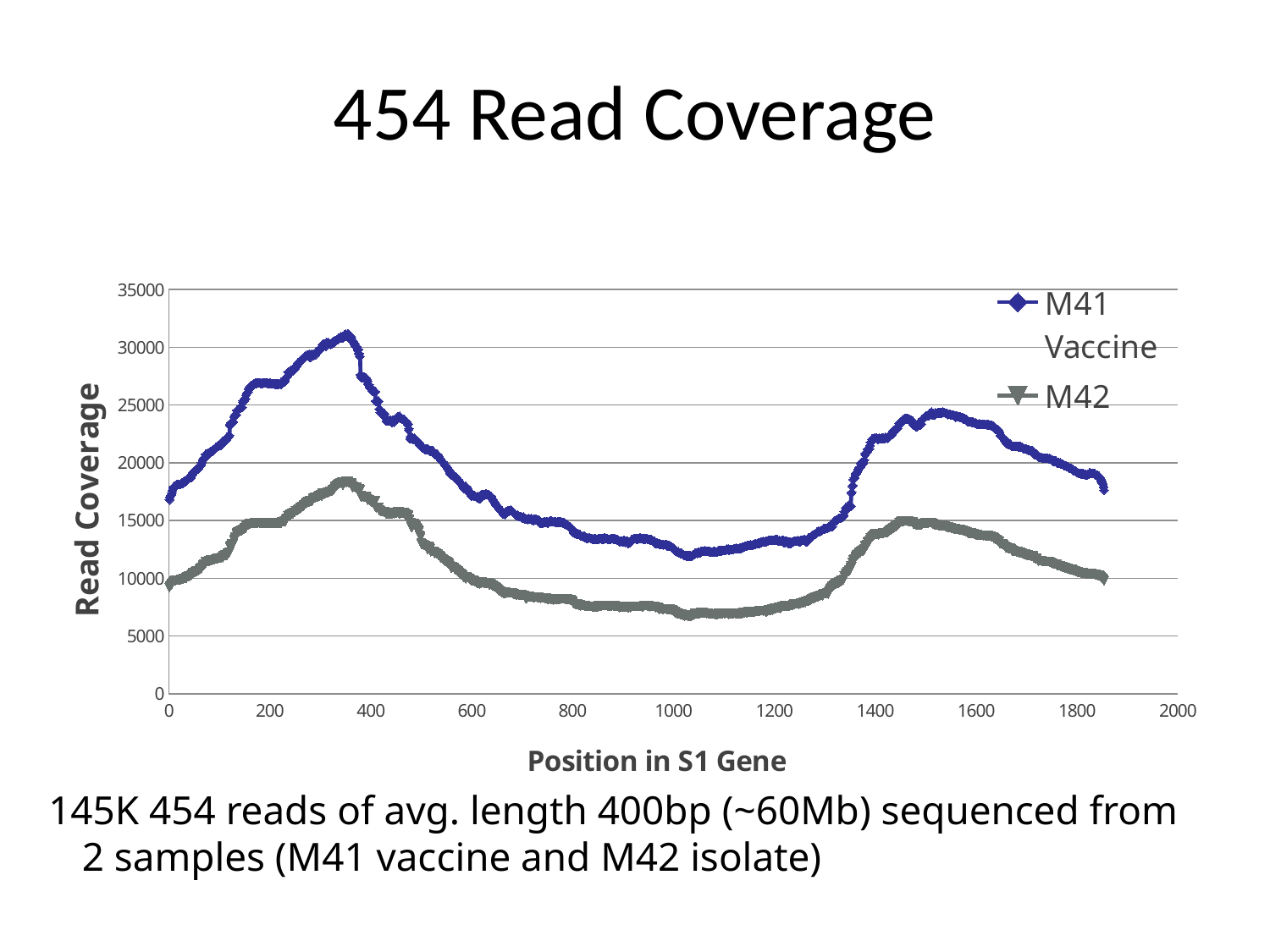
At position 1000, is the read coverage for M41 Vaccine greater or less than 15000? less At position 1600, is the read coverage for M41 Vaccine greater or less than 20000? greater What kind of chart is shown on the slide? line chart Does the read coverage for M42 rise or fall between position 1200 and position 1400? rise What are the two series named in the legend? M41 Vaccine and M42 At position 0, is the read coverage for M41 Vaccine greater or less than 15000? greater Which series has the higher read coverage across the S1 gene, M41 Vaccine or M42? M41 Vaccine Does the read coverage for M41 Vaccine rise or fall between position 400 and position 1000? fall What is the label of the x axis? Position in S1 Gene How many series does the legend list? 2